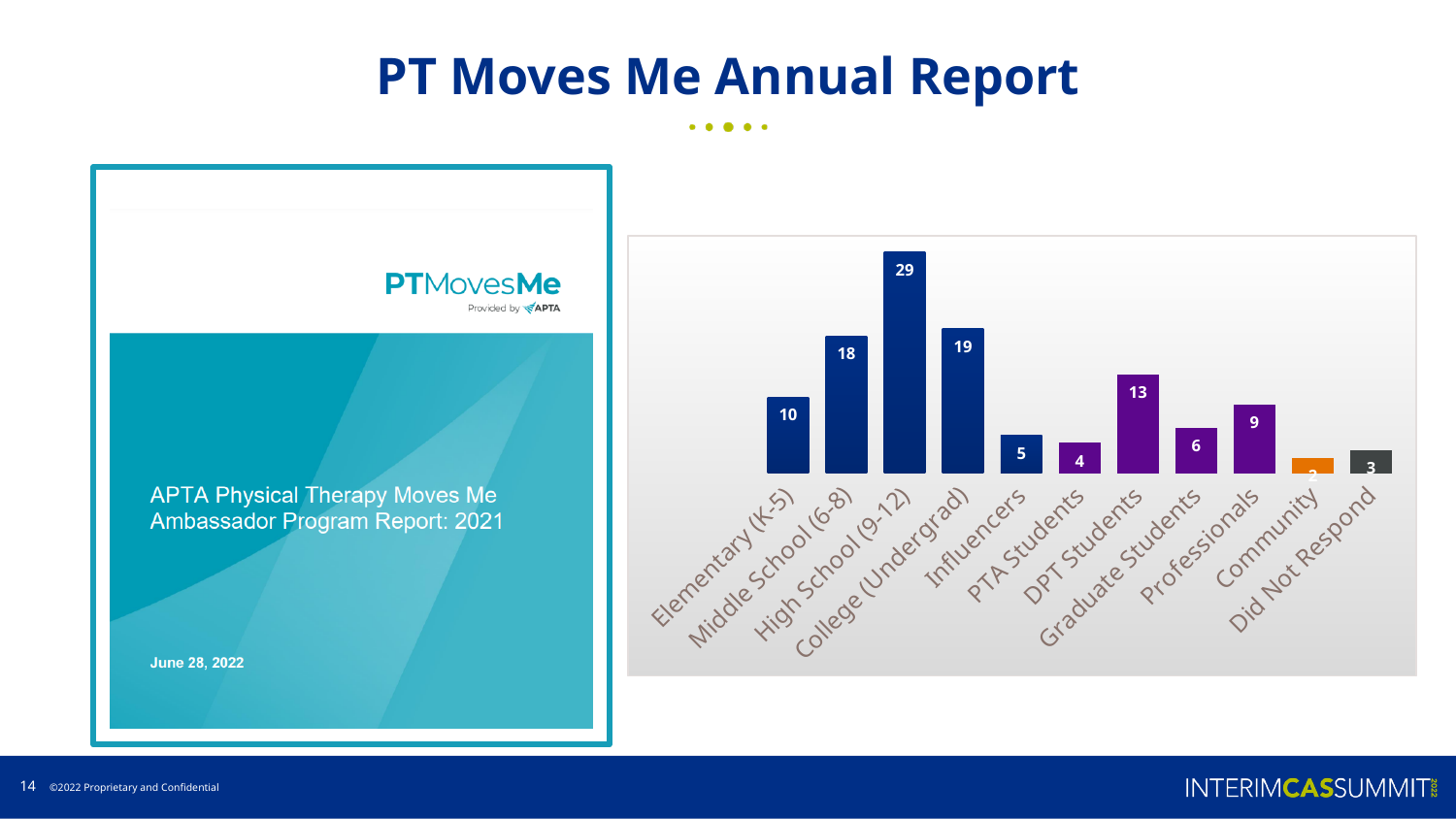
What is the value for Community? 2 What is the value for High School (9-12)? 29 What is the difference between the values for Middle School (6-8) and Elementary (K-5)? 8 What is the value for DPT Students? 13 Which category has the highest value? High School (9-12) Which category has the lowest value? Community What kind of chart is shown on the slide? Bar chart What is the difference between the values for High School (9-12) and College (Undergrad)? 10 How many categories are shown on the x axis? 11 Which is larger, the value for Influencers or the value for PTA Students? Influencers What colour is the bar for Community? Orange Which is larger, the value for Professionals or the value for Graduate Students? Professionals